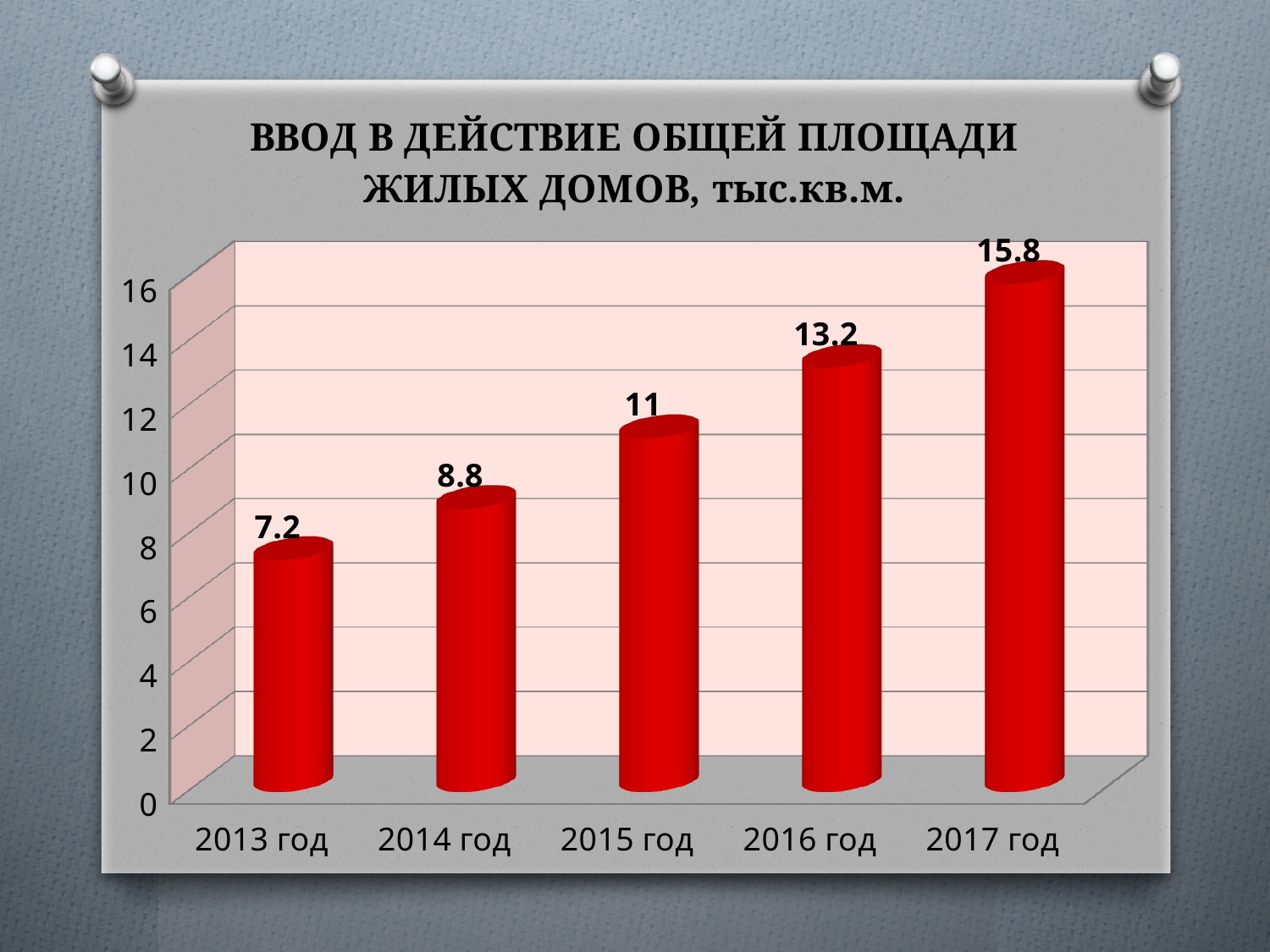
What is the value for 2017 год? 15.8 Which year has the lowest value? 2013 год What kind of chart is shown on the slide? bar chart Which is larger, the value for 2014 год or the value for 2016 год? 2016 год What is the difference between the values for 2016 год and 2014 год? 4.4 What is the value for 2015 год? 11 Is the value for 2016 год greater or less than 12? greater What is the difference between the values for 2017 год and 2013 год? 8.6 Which year has the highest value? 2017 год How many years are shown on the chart? 5 Do the values rise or fall from 2013 год to 2017 год? rise What is the value for 2013 год? 7.2